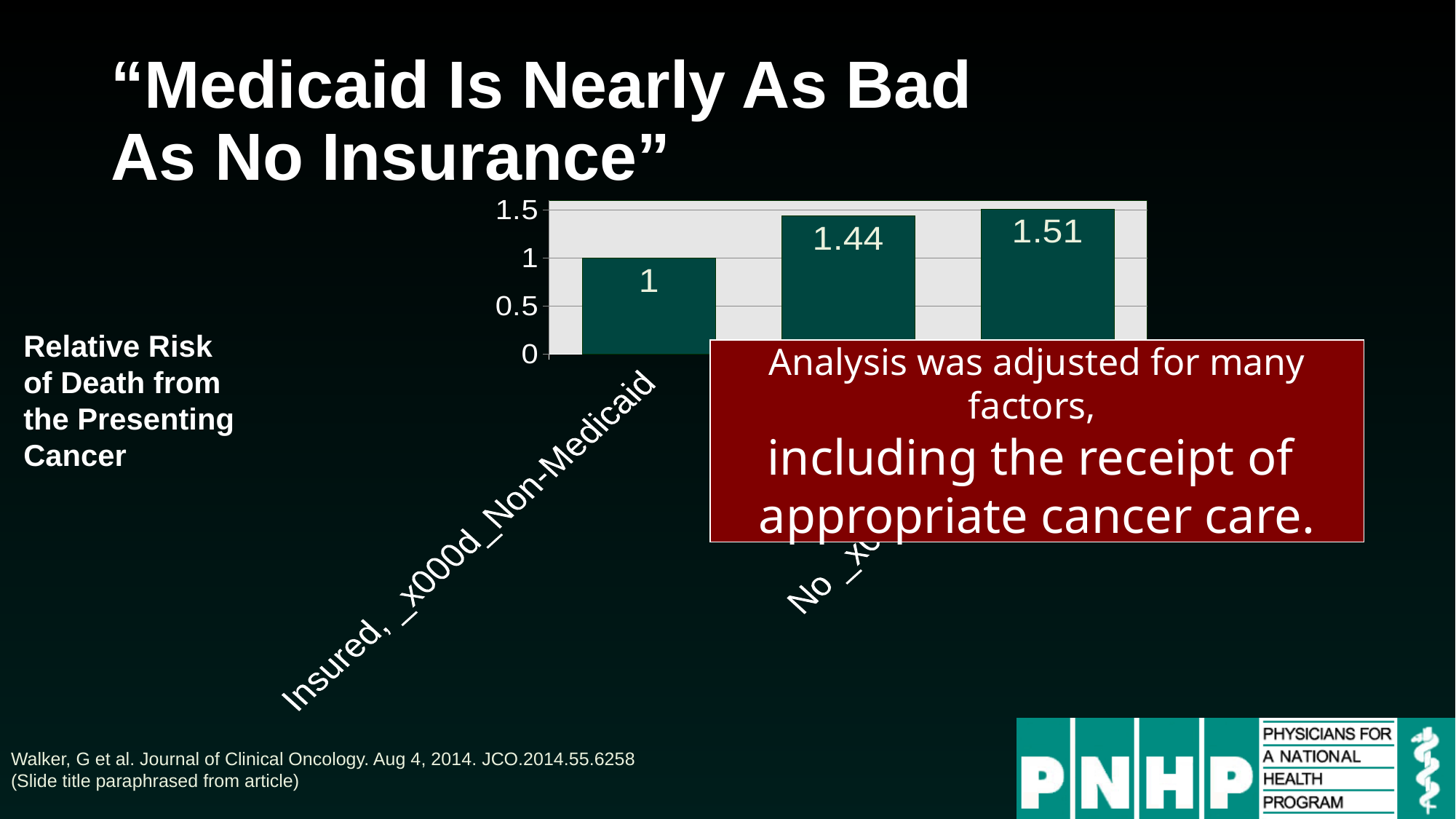
Is the value of the middle bar greater or less than 1? greater What quantity does the chart's y axis represent, according to the text to the left of the chart? Relative Risk of Death from the Presenting Cancer What is the difference between the middle bar and the rightmost bar? 0.07 Do the bar values rise or fall from left to right across the chart? rise Which bar has the highest value? the third (rightmost) bar, 1.51 How many bars are plotted in the chart? 3 What is the value of the second (middle) bar in the chart? 1.44 Which bar has the lowest value? Insured, Non-Medicaid (1) What kind of chart is shown on the slide? bar chart What is the value of the bar labelled "Insured, Non-Medicaid"? 1 What is the value of the third (rightmost) bar in the chart? 1.51 What is the difference between the rightmost bar and the Insured, Non-Medicaid bar? 0.51